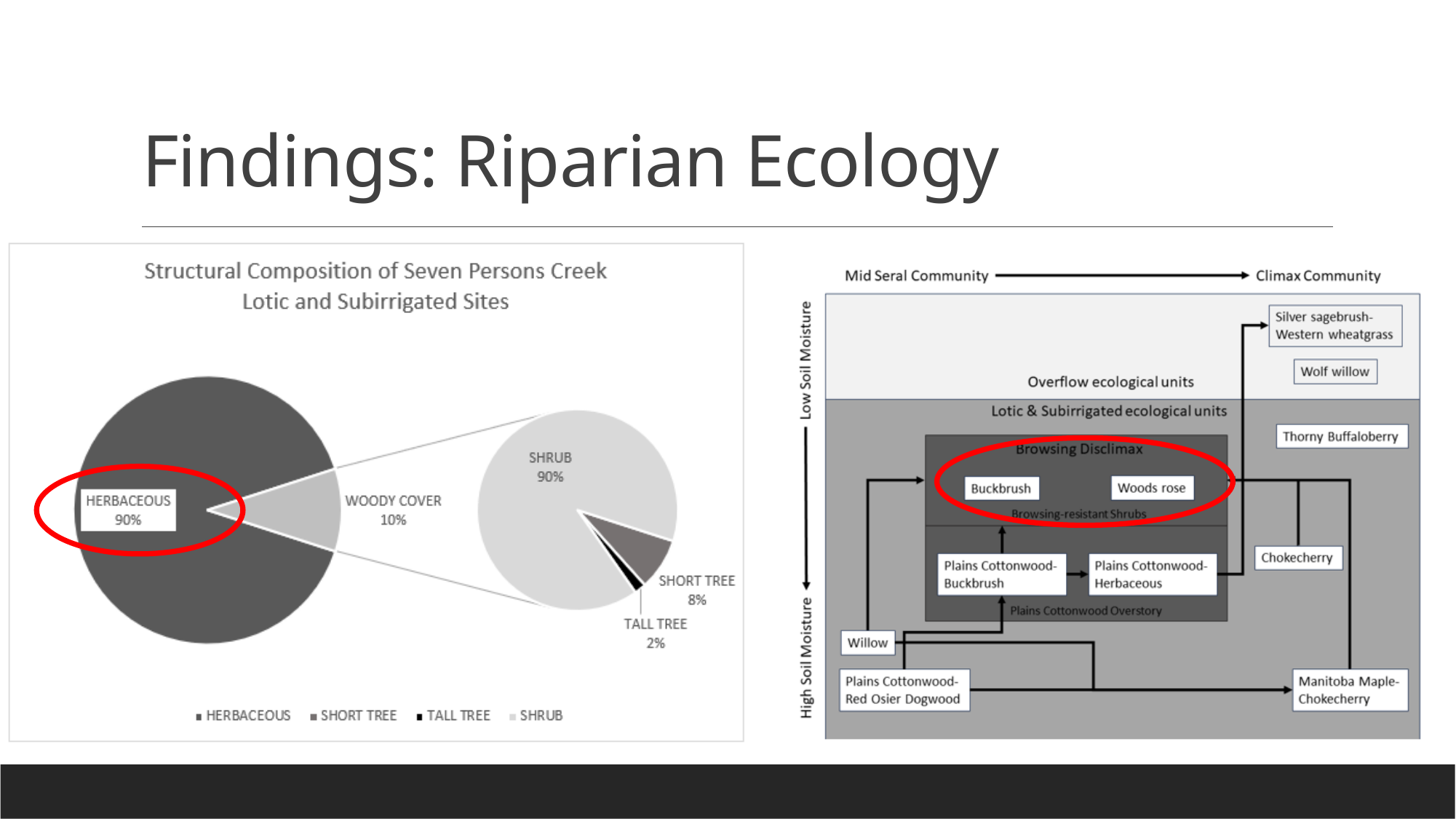
In the secondary pie breaking down woody cover, what percentage is labelled for SHORT TREE? 8% What is the title of the pie chart on the left of the slide? Structural Composition of Seven Persons Creek Lotic and Subirrigated Sites In the pie chart, what is the difference in percentage points between SHORT TREE and TALL TREE? 6 In the pie chart, what percentage is labelled for HERBACEOUS? 90% In the pie chart, what percentage is labelled for WOODY COVER? 10% In the secondary pie breaking down woody cover, which category has the largest share? SHRUB In the secondary pie breaking down woody cover, what percentage is labelled for SHRUB? 90% In the secondary pie breaking down woody cover, which category has the smallest share? TALL TREE What kind of chart is the 'Structural Composition of Seven Persons Creek Lotic and Subirrigated Sites' chart? Pie chart In the pie chart, which is larger, HERBACEOUS or WOODY COVER? HERBACEOUS In the secondary pie breaking down woody cover, what percentage is labelled for TALL TREE? 2% How many entries does the legend of the pie chart list? 4